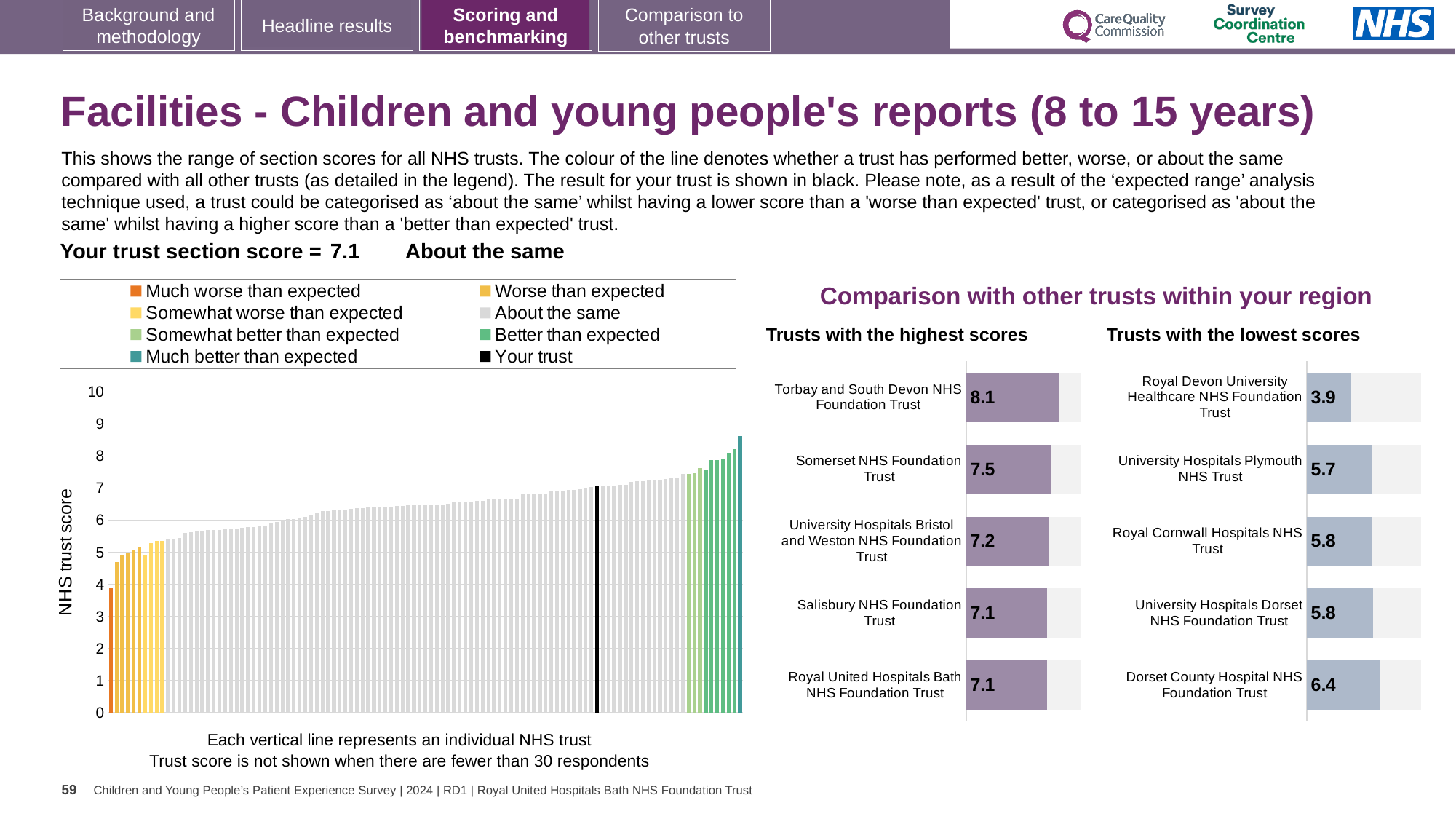
In the 'Trusts with the lowest scores' chart, what is the difference between the scores of Dorset County Hospital NHS Foundation Trust and Royal Devon University Healthcare NHS Foundation Trust? 2.5 In the 'Trusts with the highest scores' chart, what is the difference between the scores of Torbay and South Devon NHS Foundation Trust and Somerset NHS Foundation Trust? 0.6 In the 'Trusts with the lowest scores' chart, which trust has the lowest score? Royal Devon University Healthcare NHS Foundation Trust What kind of chart is the large chart on the left showing the range of NHS trust scores? Bar chart In the large chart on the left, do the trust scores rise or fall from left to right along the x axis? Rise In the 'Trusts with the highest scores' chart, which has the larger score: Somerset NHS Foundation Trust or University Hospitals Bristol and Weston NHS Foundation Trust? Somerset NHS Foundation Trust How many entries does the legend of the large chart on the left list? 8 In the 'Trusts with the lowest scores' chart, what is the score for Royal Devon University Healthcare NHS Foundation Trust? 3.9 How many trusts are shown in the 'Trusts with the highest scores' chart? 5 In the 'Trusts with the lowest scores' chart, what is the score for Dorset County Hospital NHS Foundation Trust? 6.4 In the 'Trusts with the highest scores' chart, what is the score for Torbay and South Devon NHS Foundation Trust? 8.1 In the 'Trusts with the highest scores' chart, which trust has the highest score? Torbay and South Devon NHS Foundation Trust